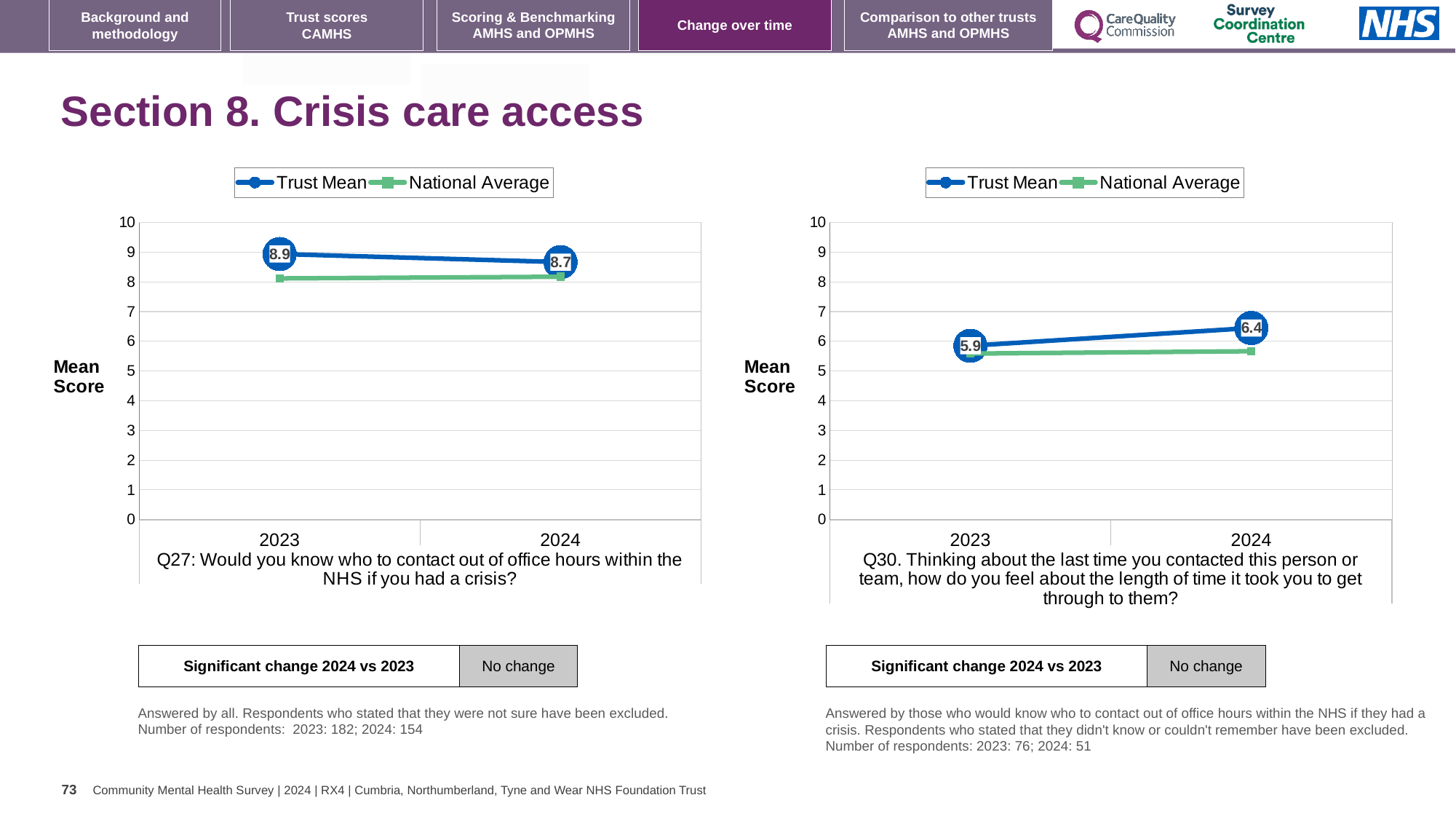
In the Q30 chart (right), what is the Trust Mean for 2023? 5.9 In the Q30 chart (right), what is the Trust Mean for 2024? 6.4 In the Q30 chart (right), which is larger in 2024, the Trust Mean or the National Average? Trust Mean In the Q30 chart (right), what is the difference between the Trust Mean in 2024 and in 2023? 0.5 In the Q27 chart (left), is the National Average for 2023 greater or less than 9? less In the Q27 chart (left), what is the Trust Mean for 2024? 8.7 In the Q27 chart (left), does the Trust Mean rise or fall from 2023 to 2024? fall In the Q27 chart (left), by how much did the Trust Mean change from 2023 to 2024? 0.2 How many series does the legend of the Q30 chart (right) list? 2 What kind of chart is the Q27 chart on the left? line chart In the Q30 chart (right), does the Trust Mean rise or fall from 2023 to 2024? rise In the Q27 chart (left), what is the Trust Mean for 2023? 8.9